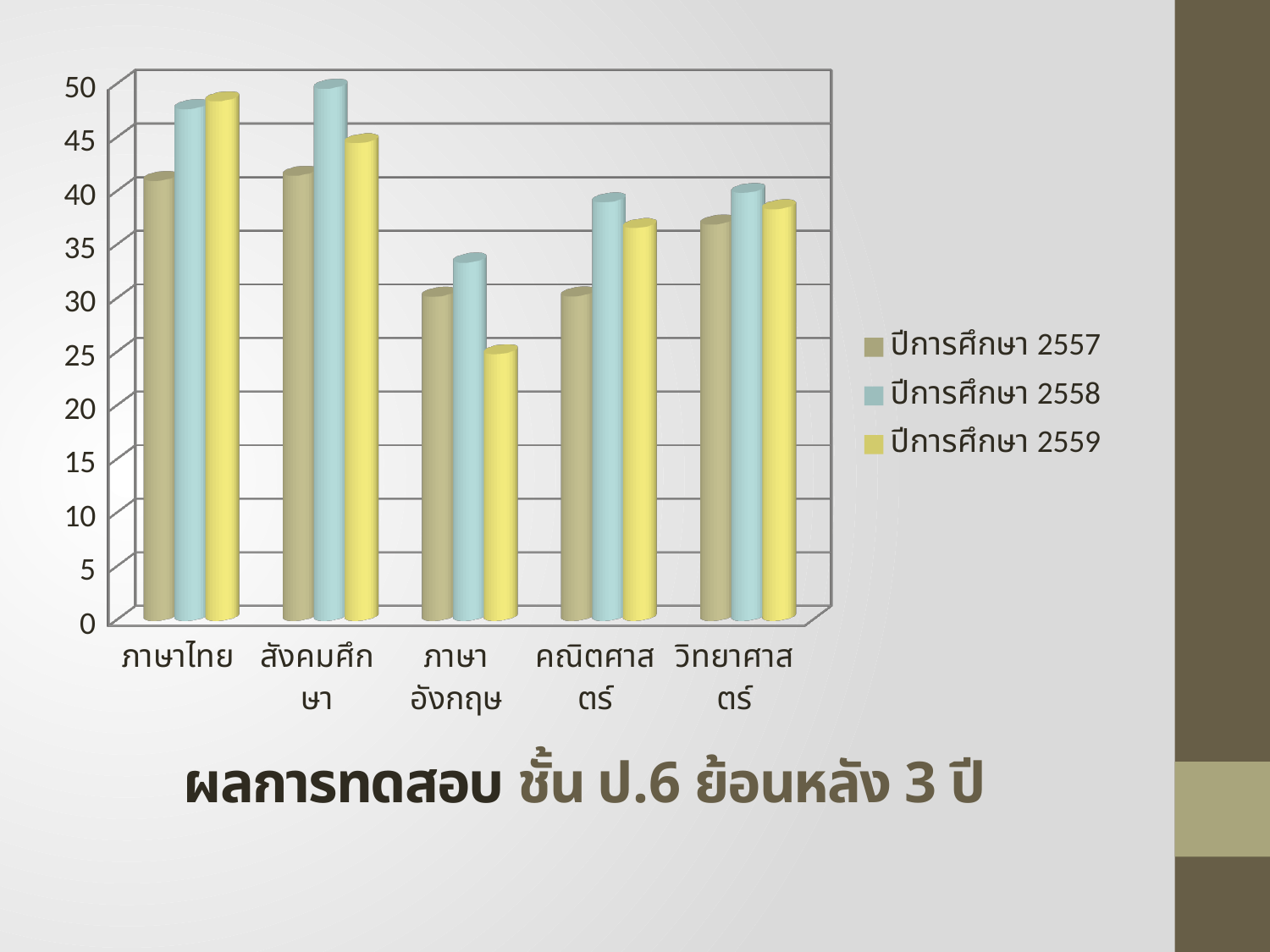
How many subject categories are shown on the x axis? 5 Which series is shown in yellow in the legend? ปีการศึกษา 2559 What kind of chart is shown on the slide? Bar chart Is the value for ภาษาอังกฤษ in ปีการศึกษา 2559 greater or less than 30? less Is the value for สังคมศึกษา in ปีการศึกษา 2558 greater or less than 45? greater What is the title of the chart? ผลการทดสอบ ชั้น ป.6 ย้อนหลัง 3 ปี In ปีการศึกษา 2558, which is larger: ภาษาอังกฤษ or คณิตศาสตร์? คณิตศาสตร์ Which subject has the lowest value in ปีการศึกษา 2559? ภาษาอังกฤษ In ปีการศึกษา 2559, which is larger: ภาษาไทย or สังคมศึกษา? ภาษาไทย Which subject has the highest value in ปีการศึกษา 2558? สังคมศึกษา Is the value for วิทยาศาสตร์ in ปีการศึกษา 2557 greater or less than 35? greater How many series does the legend list? 3